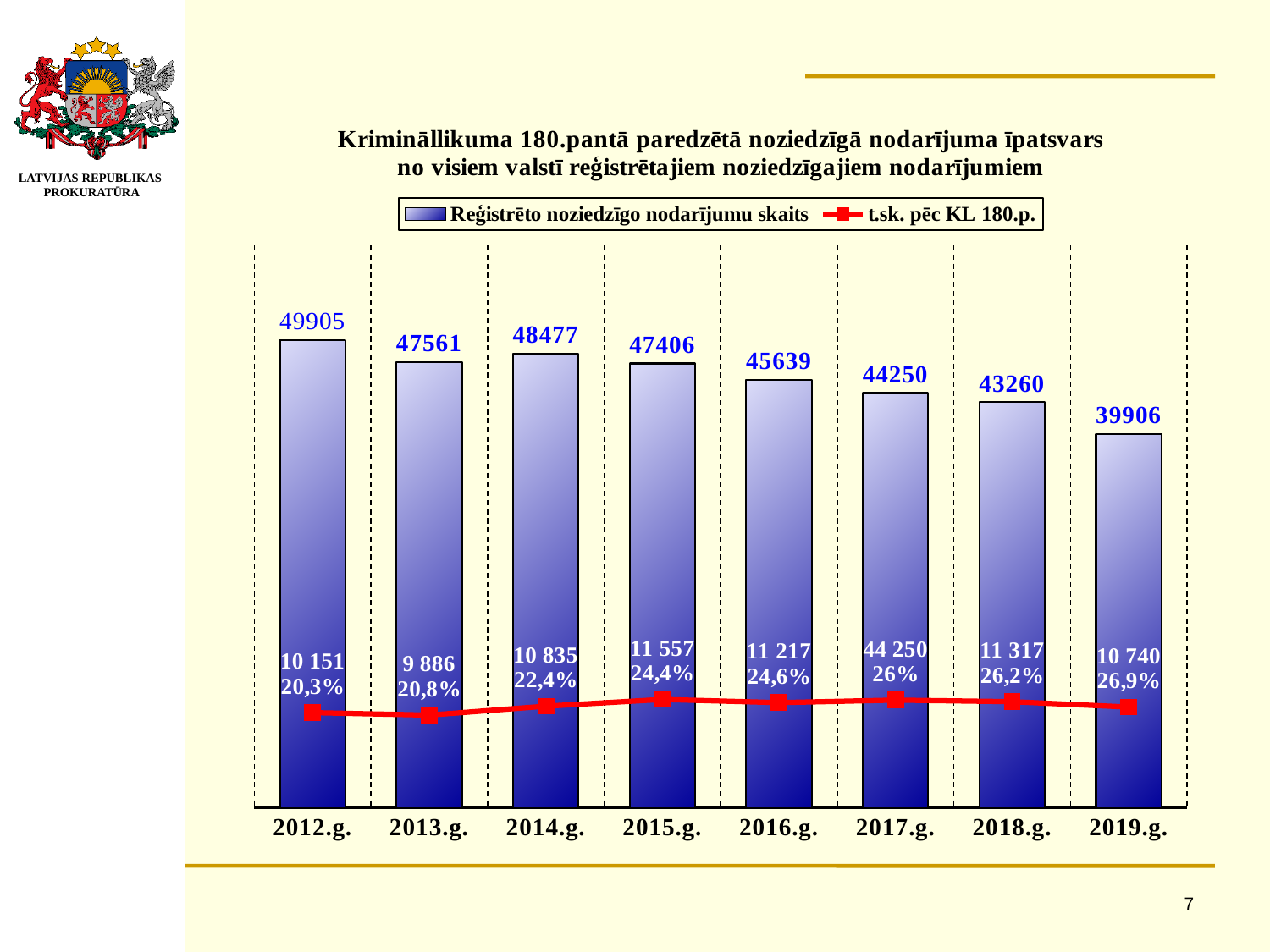
What count is printed for the 't.sk. pēc KL 180.p.' series in 2015.g.? 11 557 What is the value of the 'Reģistrēto noziedzīgo nodarījumu skaits' bar for 2019.g.? 39906 What is the difference between the 'Reģistrēto noziedzīgo nodarījumu skaits' values for 2012.g. and 2019.g.? 9999 How many years are shown on the x axis of the chart? 8 Which year has the lowest 'Reģistrēto noziedzīgo nodarījumu skaits' bar? 2019.g. What percentage is printed for the 't.sk. pēc KL 180.p.' series in 2019.g.? 26,9% What is the value of the 'Reģistrēto noziedzīgo nodarījumu skaits' bar for 2012.g.? 49905 Do the percentages printed for the 't.sk. pēc KL 180.p.' series rise or fall from 2012.g. to 2019.g.? rise Which is larger, the 'Reģistrēto noziedzīgo nodarījumu skaits' bar for 2013.g. or for 2014.g.? 2014.g. How many series does the legend list? 2 Which year has the highest 'Reģistrēto noziedzīgo nodarījumu skaits' bar? 2012.g. What colour is the 't.sk. pēc KL 180.p.' line in the chart? red